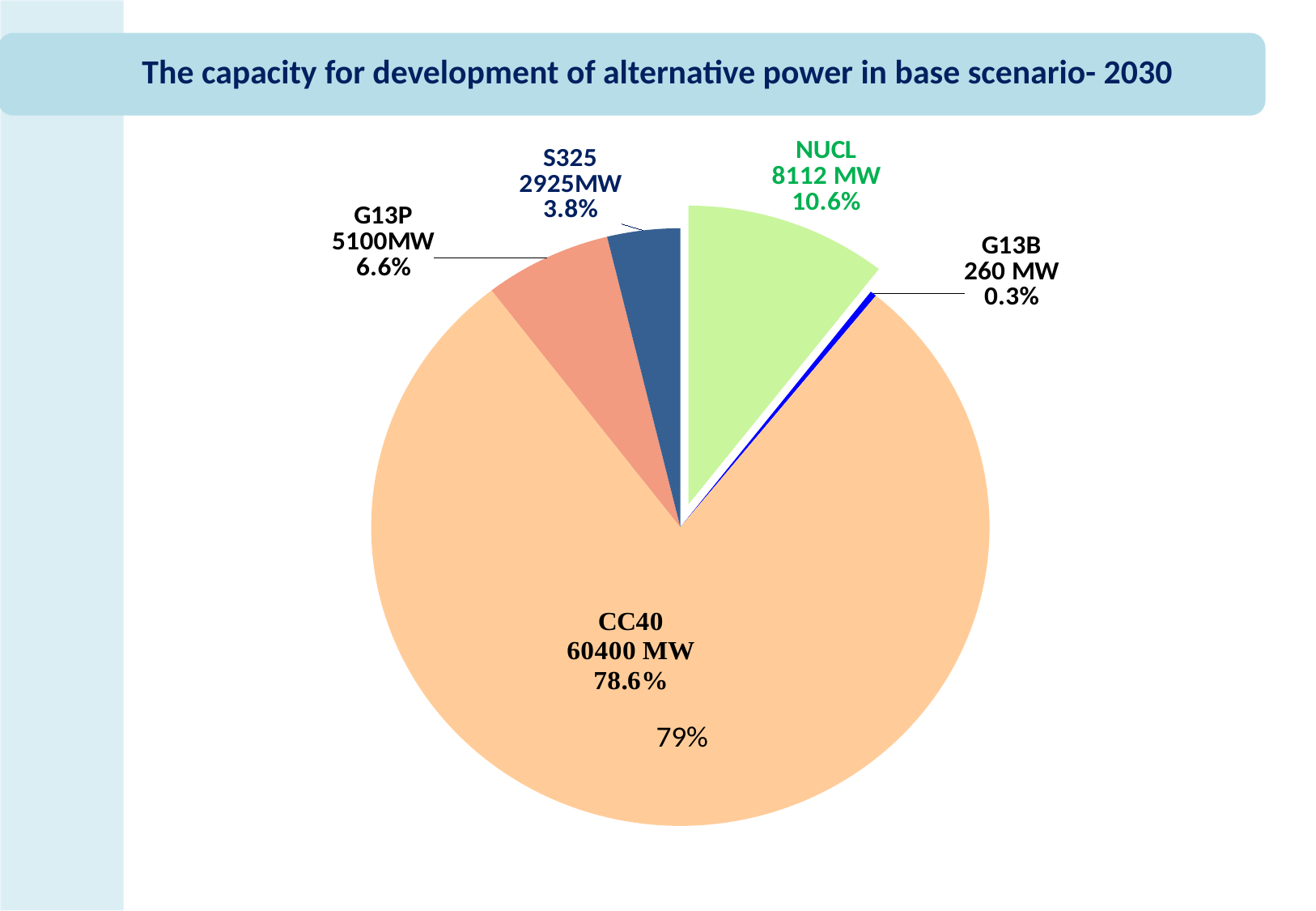
What share of the pie does G13P represent? 6.6% What is the difference in MW between NUCL and G13P? 3012 MW What capacity in MW is shown for NUCL? 8112 MW What share of the pie does S325 represent? 3.8% Which category has the largest slice of the pie? CC40 Which category has the smallest slice of the pie? G13B What type of chart is shown on the slide? pie chart Which is larger in MW, G13P or S325? G13P How many slices does the pie chart have? 5 What share of the pie does NUCL represent? 10.6% What capacity in MW is shown for CC40? 60400 MW What capacity in MW is shown for G13B? 260 MW